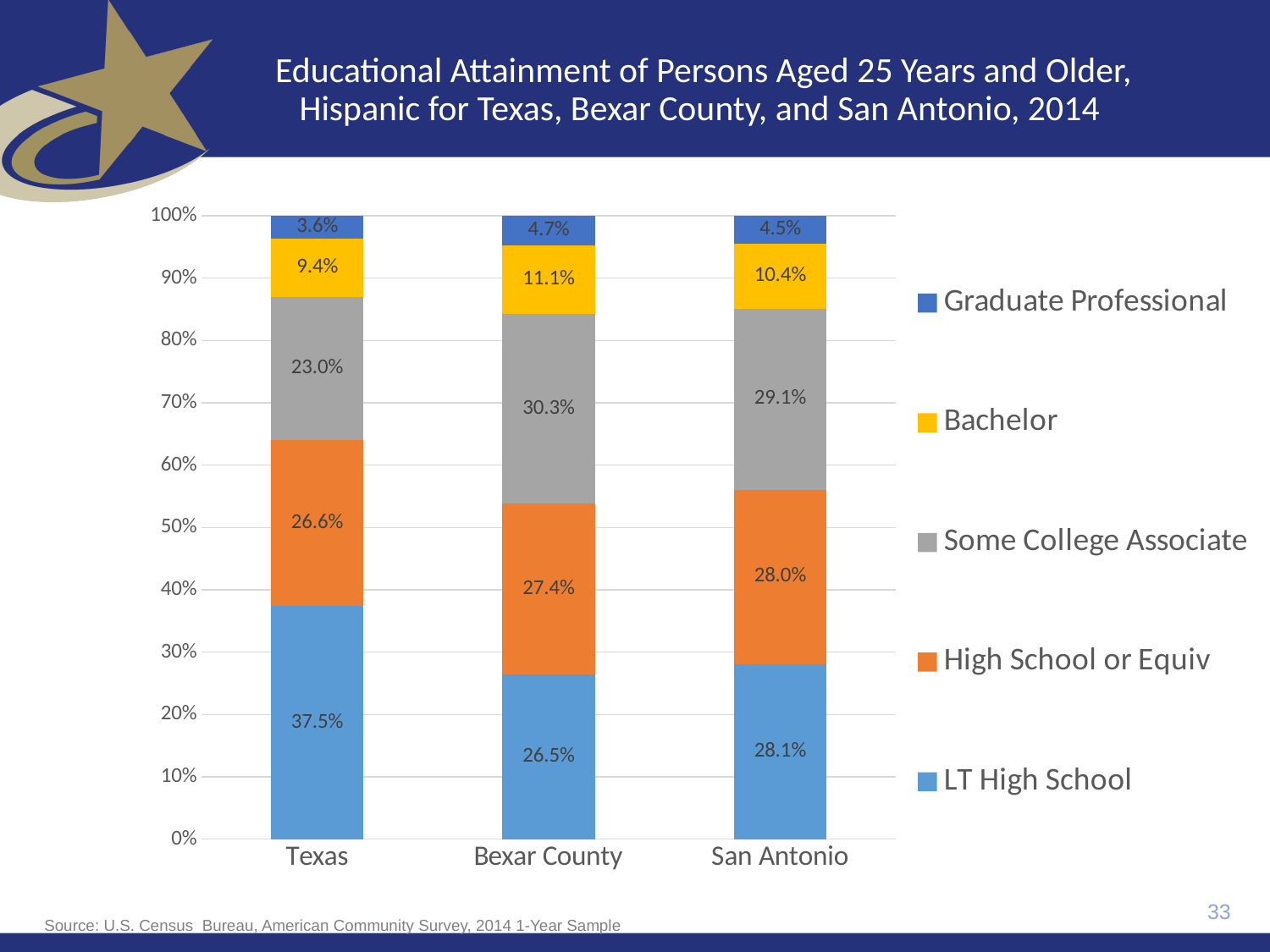
How many areas are shown on the x axis? 3 How many series does the legend list? 5 What is the Some College Associate value for San Antonio? 29.1% What kind of chart is shown on the slide? Stacked bar chart Which is larger: the High School or Equiv share for San Antonio or for Texas? San Antonio What is the Graduate Professional value for Texas? 3.6% What percentage of Hispanic persons aged 25 and older in Texas have less than a high school education? 37.5% Which colour represents the Bachelor series in the legend? Yellow Which area has the lowest Graduate Professional share? Texas What is the Bachelor share for Bexar County? 11.1% Which area has the highest LT High School share? Texas How much higher is the Some College Associate share in Bexar County than in Texas? 7.3 percentage points